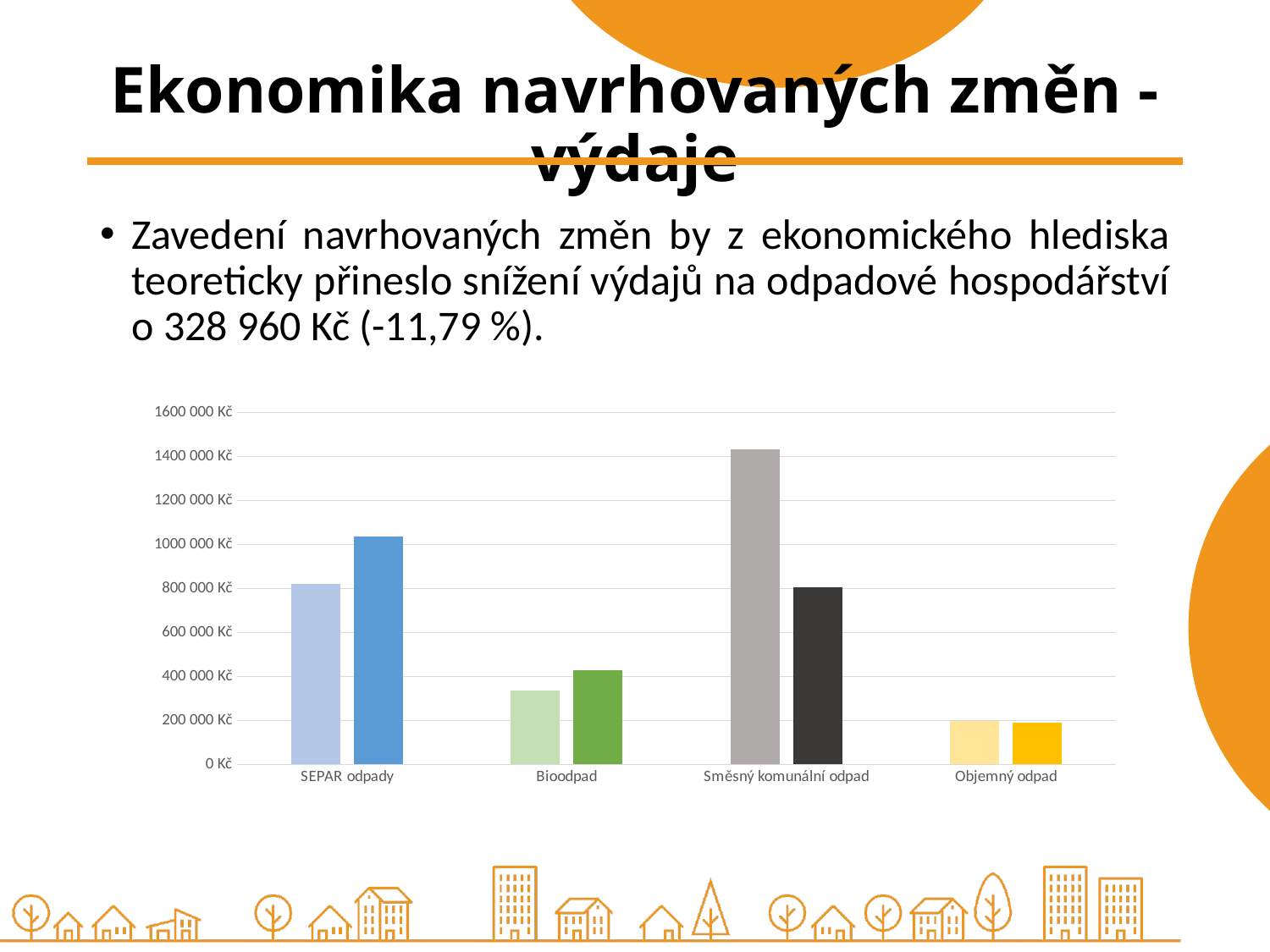
Is the value of the lighter (left) bar for SEPAR odpady greater or less than 1000 000 Kč? less Which category has the shortest bars in the chart? Objemný odpad Are the bars for Objemný odpad greater or less than 400 000 Kč? less For Směsný komunální odpad, which bar is larger, the lighter (left) bar or the darker (right) bar? the lighter (left) bar How many categories are shown on the x axis of the chart? 4 Is the value of the lighter (left) bar for Směsný komunální odpad greater or less than 1200 000 Kč? greater For SEPAR odpady, which bar is larger, the lighter (left) bar or the darker (right) bar? the darker (right) bar Which category contains the tallest bar in the chart? Směsný komunální odpad What kind of chart is shown on the slide? bar chart How many bars are plotted for each category in the chart? 2